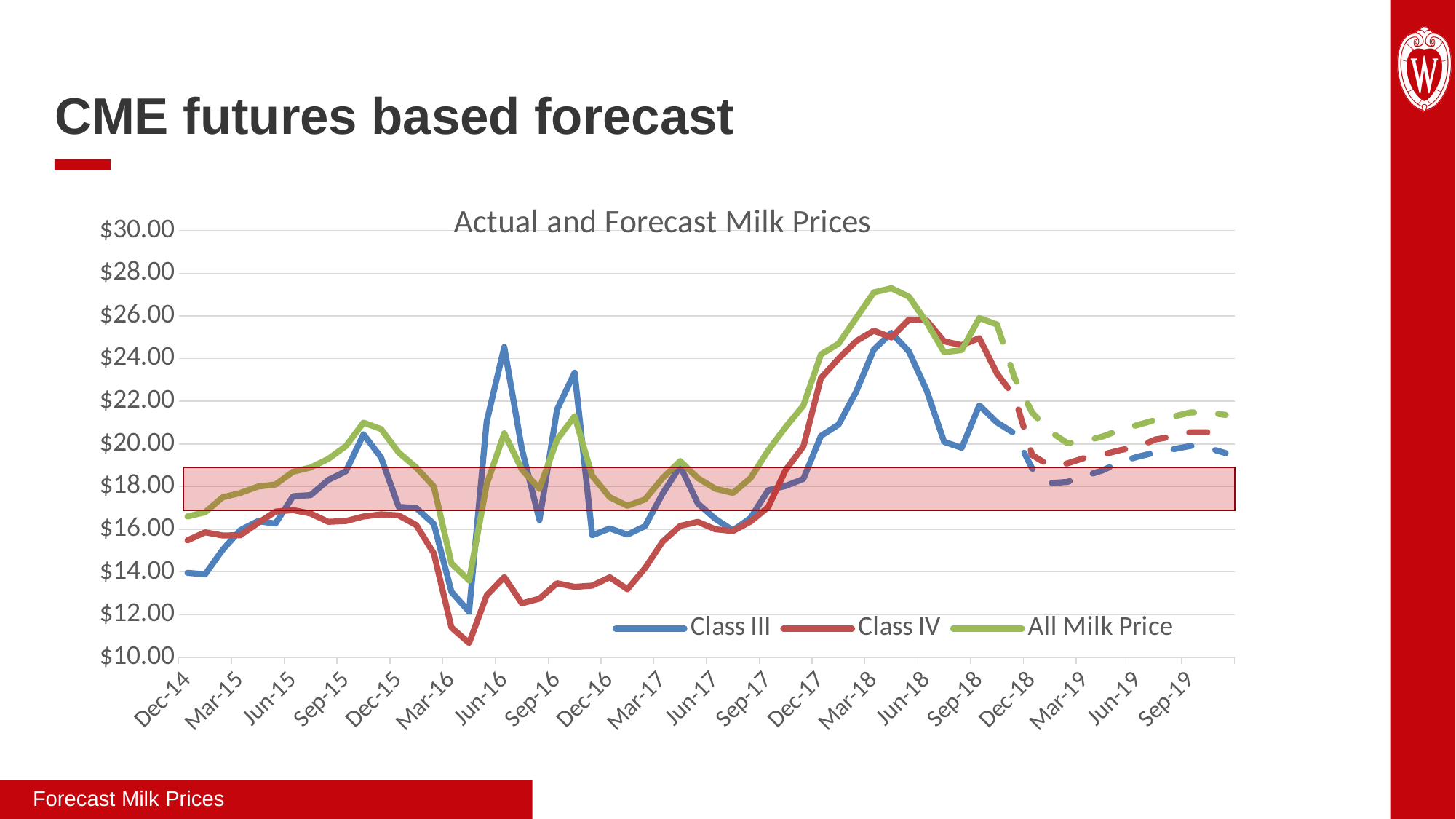
Is the Class IV value at Mar-16 greater or less than $12.00? less How many series does the legend list? 3 What kind of chart is shown on the slide? Line chart Is the Class III value at Jun-16 greater or less than $22.00? greater Does the Class IV line rise or fall from Dec-17 to Jun-18? rise Which series has the highest value at Mar-18? All Milk Price How many date labels are shown on the x axis? 20 What is the title of the chart? Actual and Forecast Milk Prices Which series are listed in the chart legend? Class III, Class IV, All Milk Price Is the All Milk Price value at Mar-18 greater or less than $26.00? greater Which series has the lowest value at Dec-14? Class III